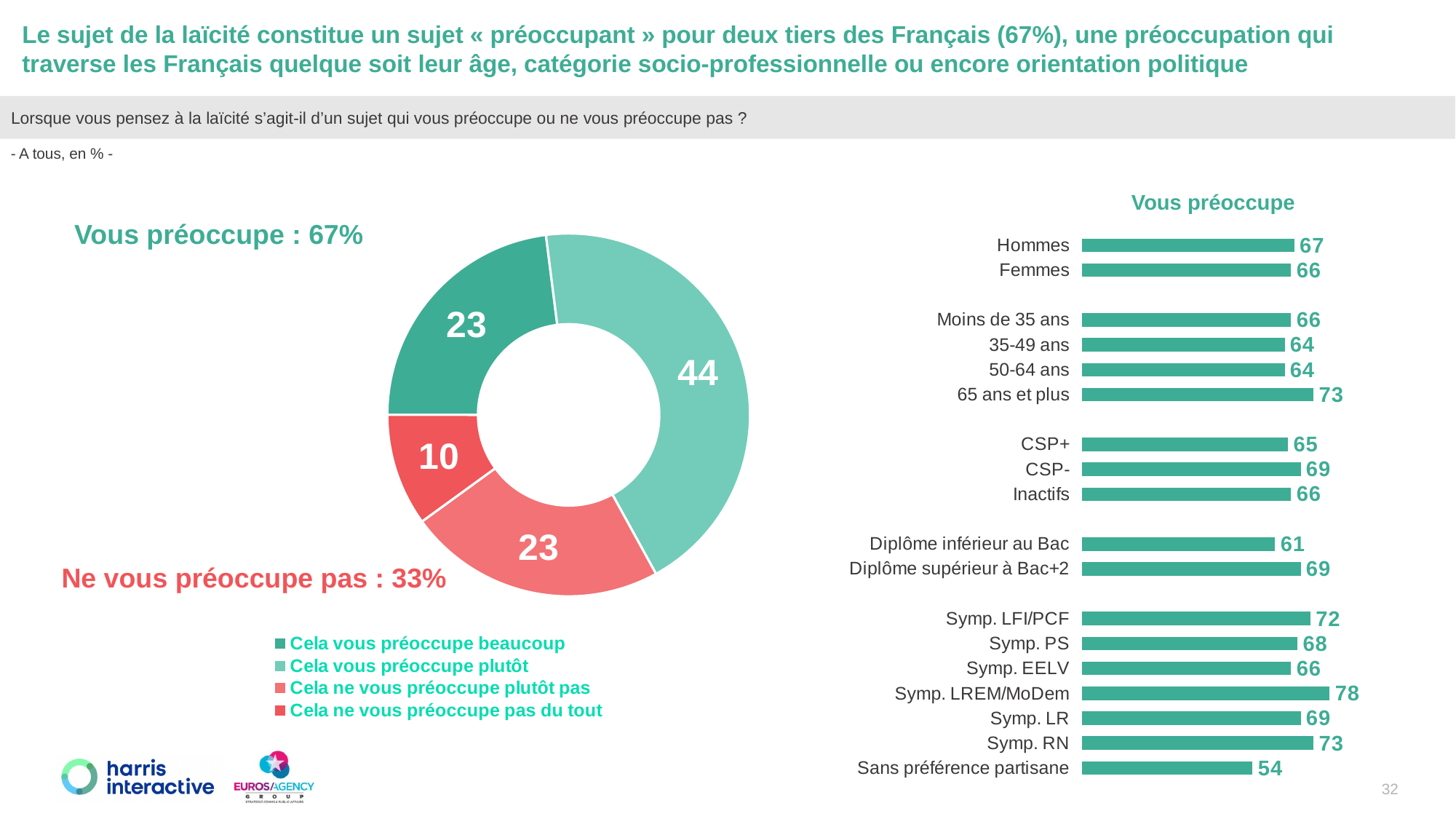
In the "Vous préoccupe" bar chart on the right, which category has the highest value? Symp. LREM/MoDem In the donut chart on the left, what is the value for "Cela ne vous préoccupe pas du tout"? 10 What kind of chart is shown on the right of the slide? Bar chart In the donut chart on the left, what is the value for "Cela vous préoccupe plutôt"? 44 In the "Vous préoccupe" bar chart on the right, what is the value for "65 ans et plus"? 73 In the "Vous préoccupe" bar chart on the right, what is the value for "Diplôme inférieur au Bac"? 61 In the donut chart on the left, which category has the largest share? Cela vous préoccupe plutôt In the "Vous préoccupe" bar chart on the right, which category has the lowest value? Sans préférence partisane In the "Vous préoccupe" bar chart on the right, which is larger: "CSP+" or "CSP-"? CSP- In the "Vous préoccupe" bar chart on the right, what is the difference between "Symp. LREM/MoDem" and "Sans préférence partisane"? 24 What kind of chart is shown on the left of the slide? Donut (pie) chart In the donut chart on the left, how many categories does the legend list? 4